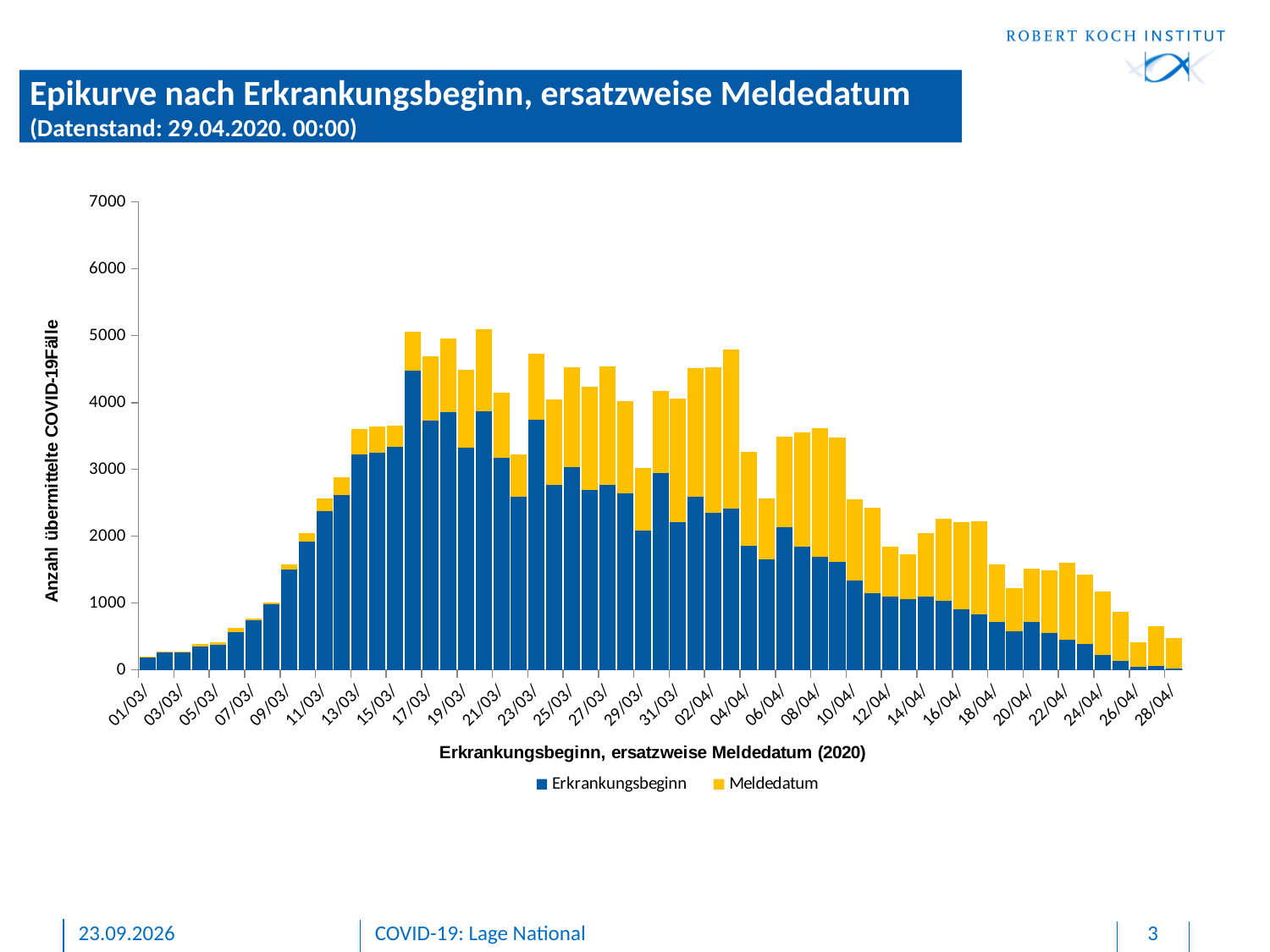
Which has the larger Erkrankungsbeginn value, 17/03 or 21/03? 17/03 Is the total stacked value for 01/03 greater or less than 1000? less Is the total stacked value for 25/03 greater or less than 4000? greater What is the title of the y axis? Anzahl übermittelte COVID-19Fälle Is the Erkrankungsbeginn value for 17/03 greater or less than 4000? less What are the two series named in the legend? Erkrankungsbeginn and Meldedatum Do the total stacked values generally rise or fall from 02/04 to 28/04? fall How many series does the legend list? 2 Which date has the highest Erkrankungsbeginn (blue) value? 16/03 What kind of chart is shown on the slide? Stacked bar chart